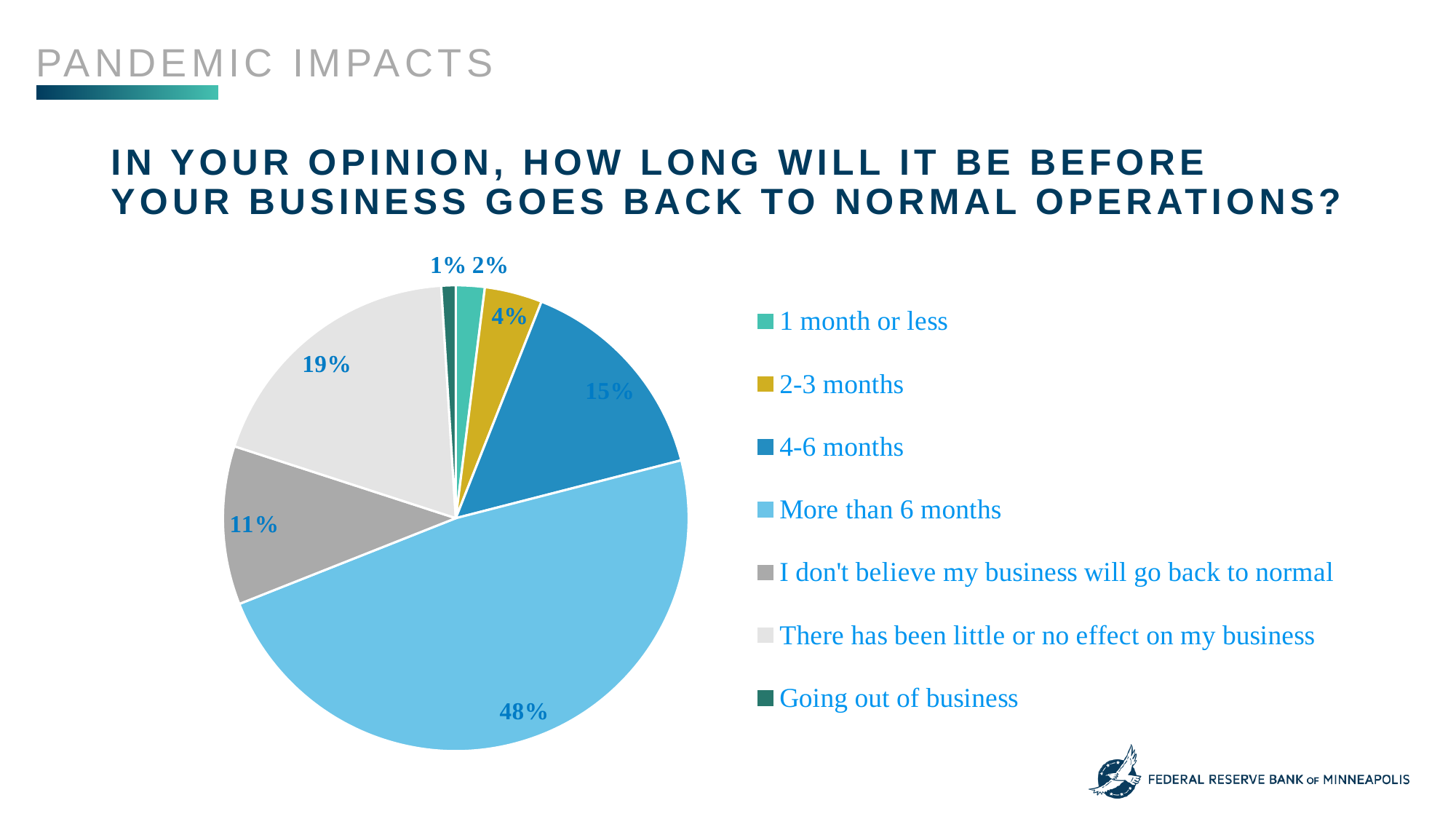
What percentage of respondents chose '2-3 months'? 4% What share of respondents said it will be more than 6 months before their business goes back to normal operations? 48% Which response has the smallest share of the pie? Going out of business Which is larger: the share for '4-6 months' or the share for 'I don't believe my business will go back to normal'? 4-6 months What percentage of respondents said they are going out of business? 1% Which response has the largest share of the pie? More than 6 months What colour is the slice for '2-3 months'? Gold What percentage of respondents chose '4-6 months'? 15% What type of chart is shown on the slide? Pie chart How many response categories are shown in the pie chart? 7 What is the difference in percentage points between 'More than 6 months' and 'There has been little or no effect on my business'? 29 What percentage of respondents said there has been little or no effect on their business? 19%